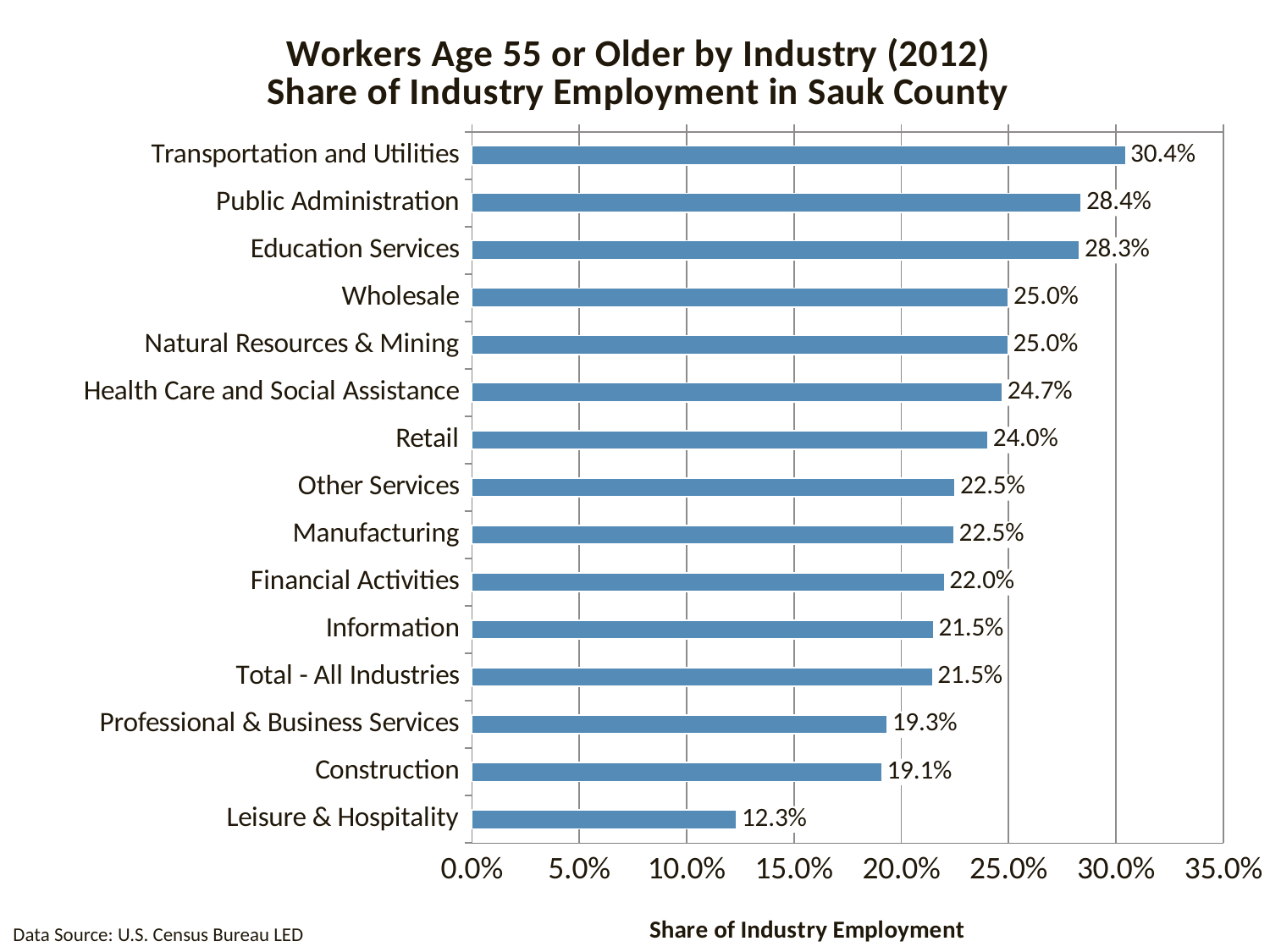
What is the share of industry employment for Transportation and Utilities? 30.4% Which industry has the lowest share of workers age 55 or older? Leisure & Hospitality What is the difference between the values for Public Administration and Construction? 9.3% What is the value shown for Health Care and Social Assistance? 24.7% Which has a larger value, Retail or Financial Activities? Retail What is the value shown for Total - All Industries? 21.5% Is the value for Professional & Business Services greater or less than 20.0%? less How many industry categories are shown on the chart? 15 What is the difference between the values for Transportation and Utilities and Leisure & Hospitality? 18.1% What kind of chart is shown on the slide? Bar chart What is the label of the horizontal axis? Share of Industry Employment Which industry has the highest share of workers age 55 or older? Transportation and Utilities